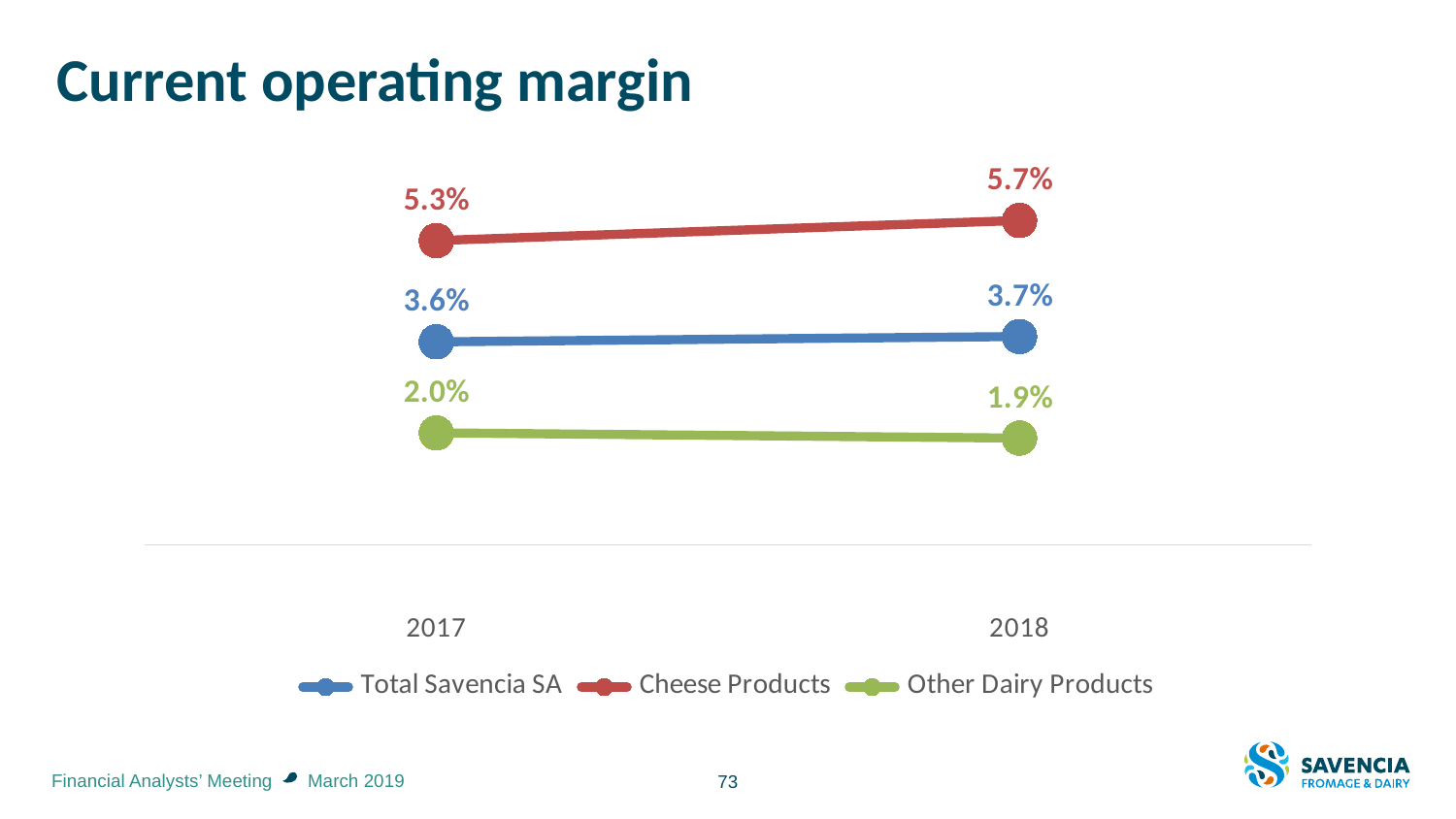
What is the current operating margin for Cheese Products in 2018? 5.7% Which series has the lowest current operating margin in 2017? Other Dairy Products Which series has the highest current operating margin in 2018? Cheese Products How many series does the legend list? 3 What is the current operating margin for Total Savencia SA in 2017? 3.6% How many years are shown on the x axis? 2 Is the Total Savencia SA margin in 2018 higher or lower than in 2017? higher What is the difference between the Cheese Products margin and the Total Savencia SA margin in 2018? 2.0% Does the Other Dairy Products margin rise or fall from 2017 to 2018? fall By how much did the Cheese Products margin change from 2017 to 2018? 0.4% What kind of chart is shown on the slide? line chart What is the current operating margin for Other Dairy Products in 2018? 1.9%